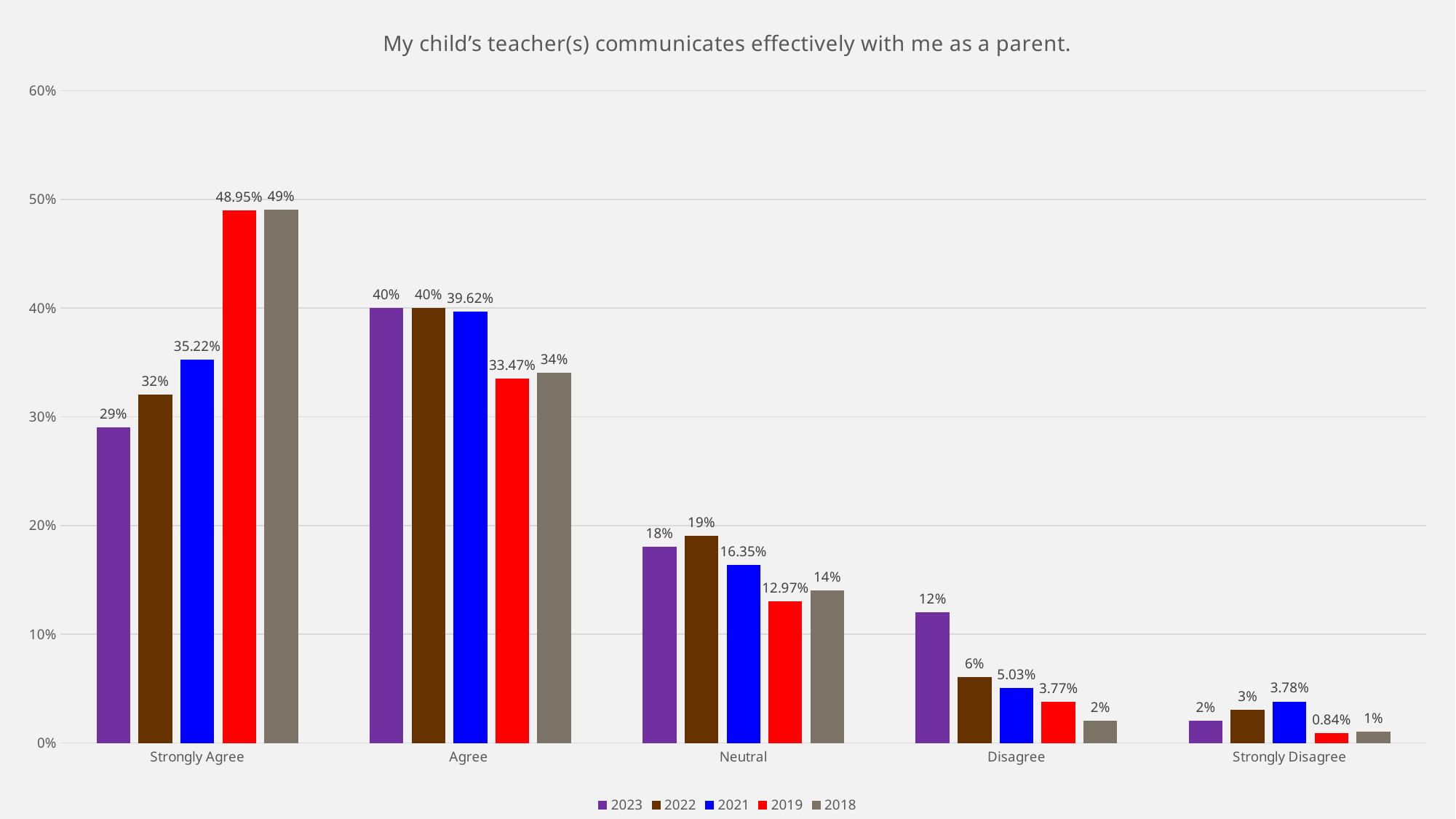
Which year has the highest value in the Strongly Agree category? 2018 Which is larger in the Neutral category: the value for 2022 or the value for 2018? 2022 What is the value for 2021 in the Neutral category? 16.35% What is the value for 2019 in the Agree category? 33.47% What kind of chart is shown on the slide? Bar chart How many response categories are shown on the x axis? 5 What is the value for 2023 in the Strongly Agree category? 29% Which year has the lowest value in the Disagree category? 2018 What is the difference between the 2023 and 2022 values in the Disagree category? 6% How many series does the legend list? 5 What is the title of the chart? My child's teacher(s) communicates effectively with me as a parent. What is the value for 2019 in the Strongly Disagree category? 0.84%